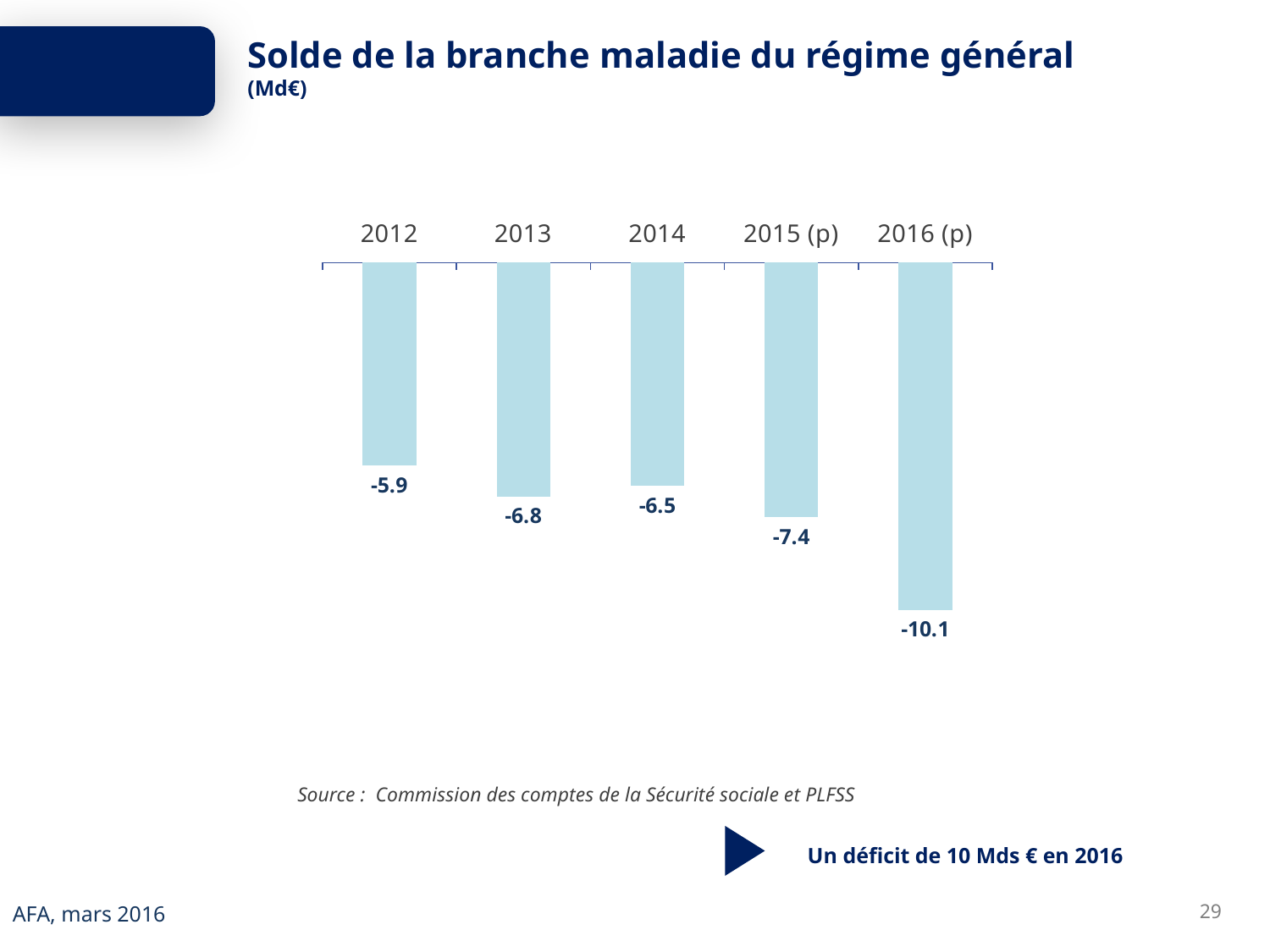
What is the value for 2014? -6.5 What is the value for 2012? -5.9 What is the title of the chart? Solde de la branche maladie du régime général Which is larger, the value for 2013 or the value for 2014? 2014 What is the value for 2016 (p)? -10.1 What unit is given under the chart title? Md€ Which year has the highest value? 2012 What is the value for 2015 (p)? -7.4 What kind of chart is this? bar chart Which year has the lowest value? 2016 (p) How many years are shown on the chart? 5 What is the difference between the values for 2016 (p) and 2015 (p)? 2.7